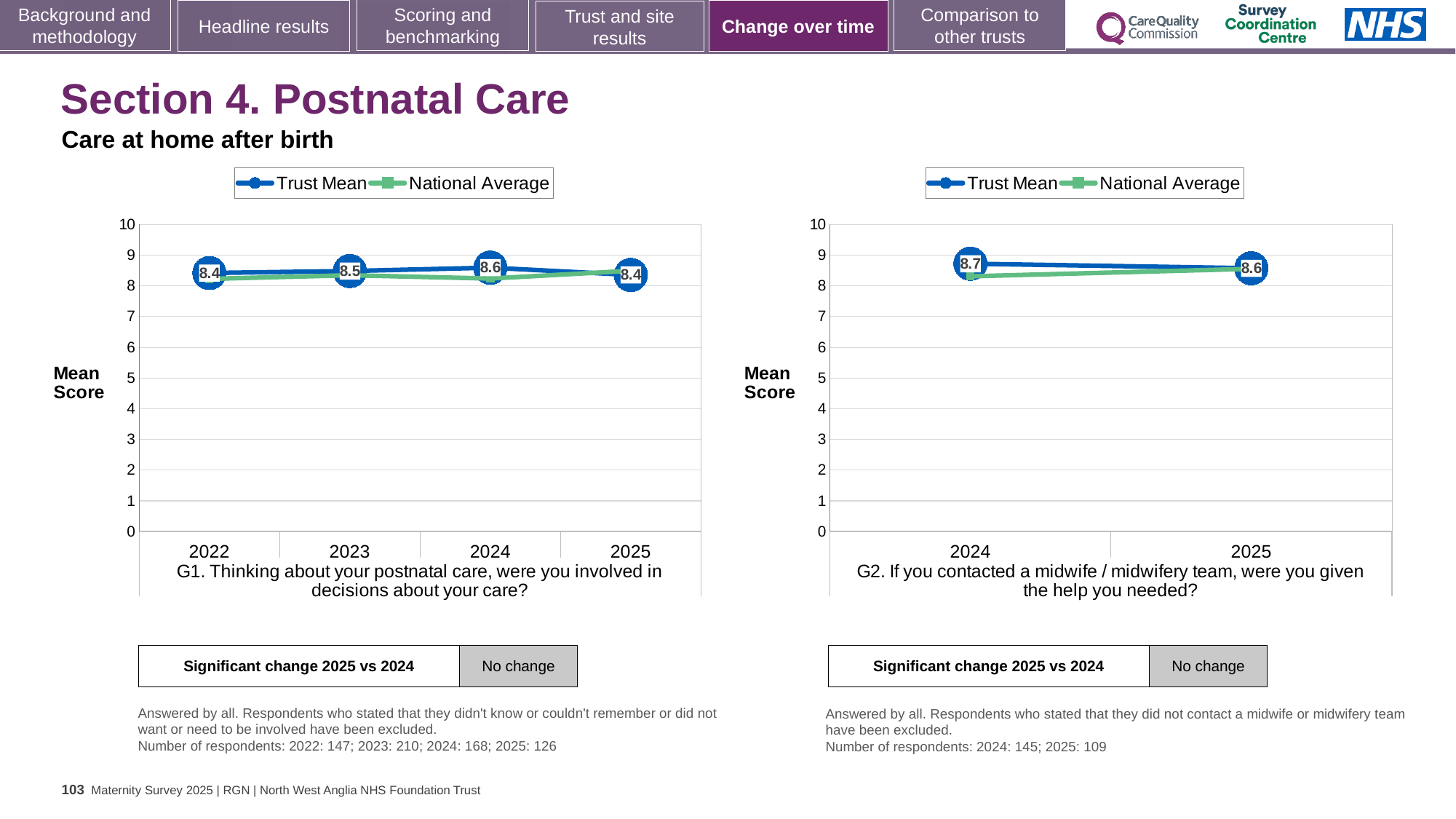
On the G1 chart (left), which year has the highest Trust Mean? 2024 On the G1 chart (left), what is the label of the y axis? Mean Score On the G1 chart (left), what is the Trust Mean for 2022? 8.4 On the G1 chart (left), what is the Trust Mean for 2024? 8.6 On the G2 chart (right), is the National Average for 2024 greater or less than 9? less On the G2 chart (right), what is the Trust Mean for 2025? 8.6 On the G2 chart (right), how many series does the legend list? 2 What type of chart is the G1 chart on the left? Line chart On the G2 chart (right), what is the difference between the Trust Mean in 2024 and in 2025? 0.1 On the G1 chart (left), what is the difference between the Trust Mean in 2024 and in 2025? 0.2 On the G1 chart (left), how many years are plotted on the x axis? 4 On the G2 chart (right), what is the Trust Mean for 2024? 8.7